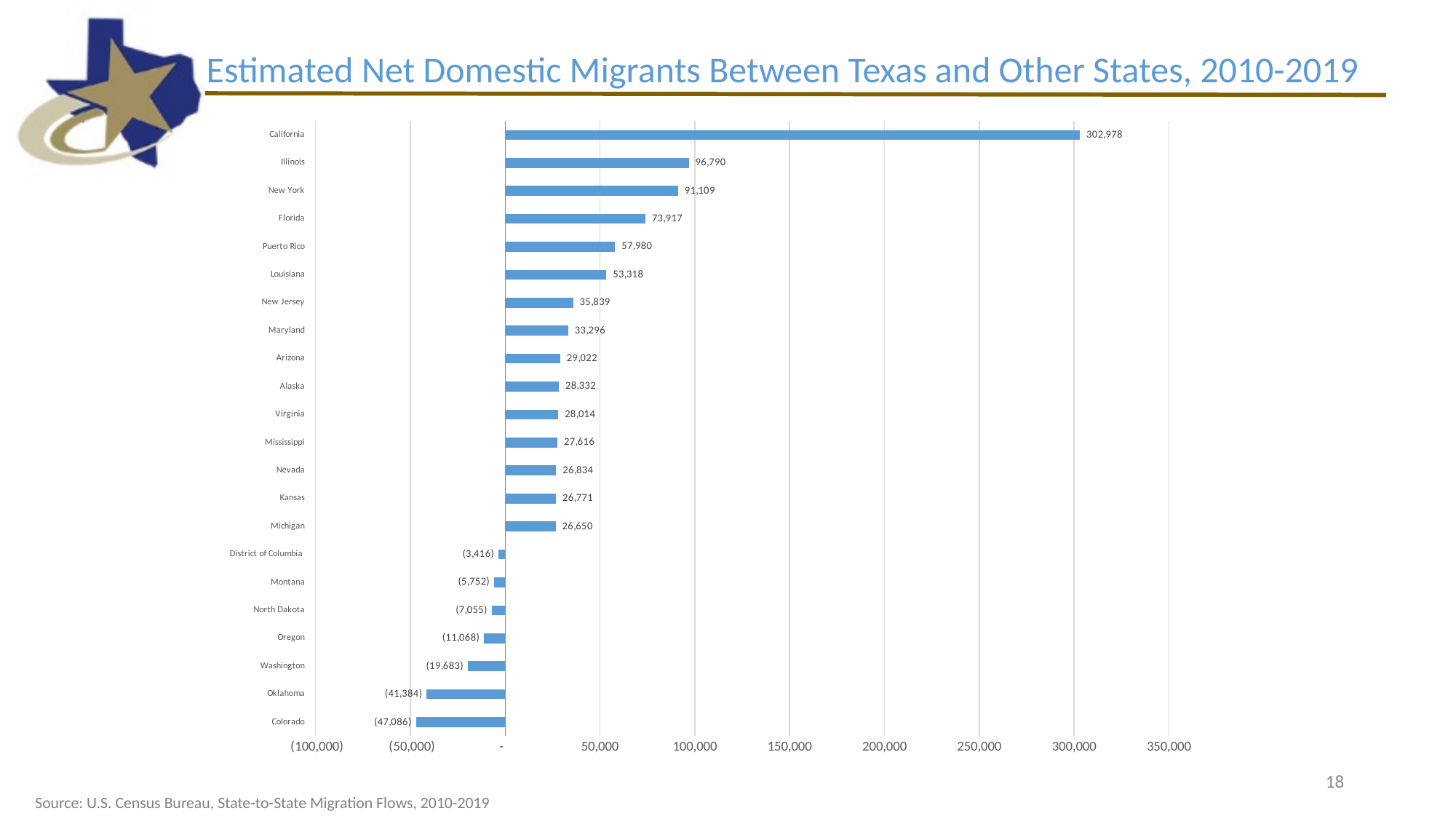
What kind of chart is shown on the slide? Bar chart What is the title of the chart? Estimated Net Domestic Migrants Between Texas and Other States, 2010-2019 What is the value for Washington? (19,683) What is the difference between the values for California and Illinois? 206,188 Which is larger, the value for Florida or the value for Puerto Rico? Florida How many categories are shown on the chart? 22 Which state has the highest value? California Which category has the lowest value? Colorado What is the value for Louisiana? 53,318 What is the value for California? 302,978 What is the difference between the values for Illinois and New York? 5,681 What is the value for Colorado? (47,086)